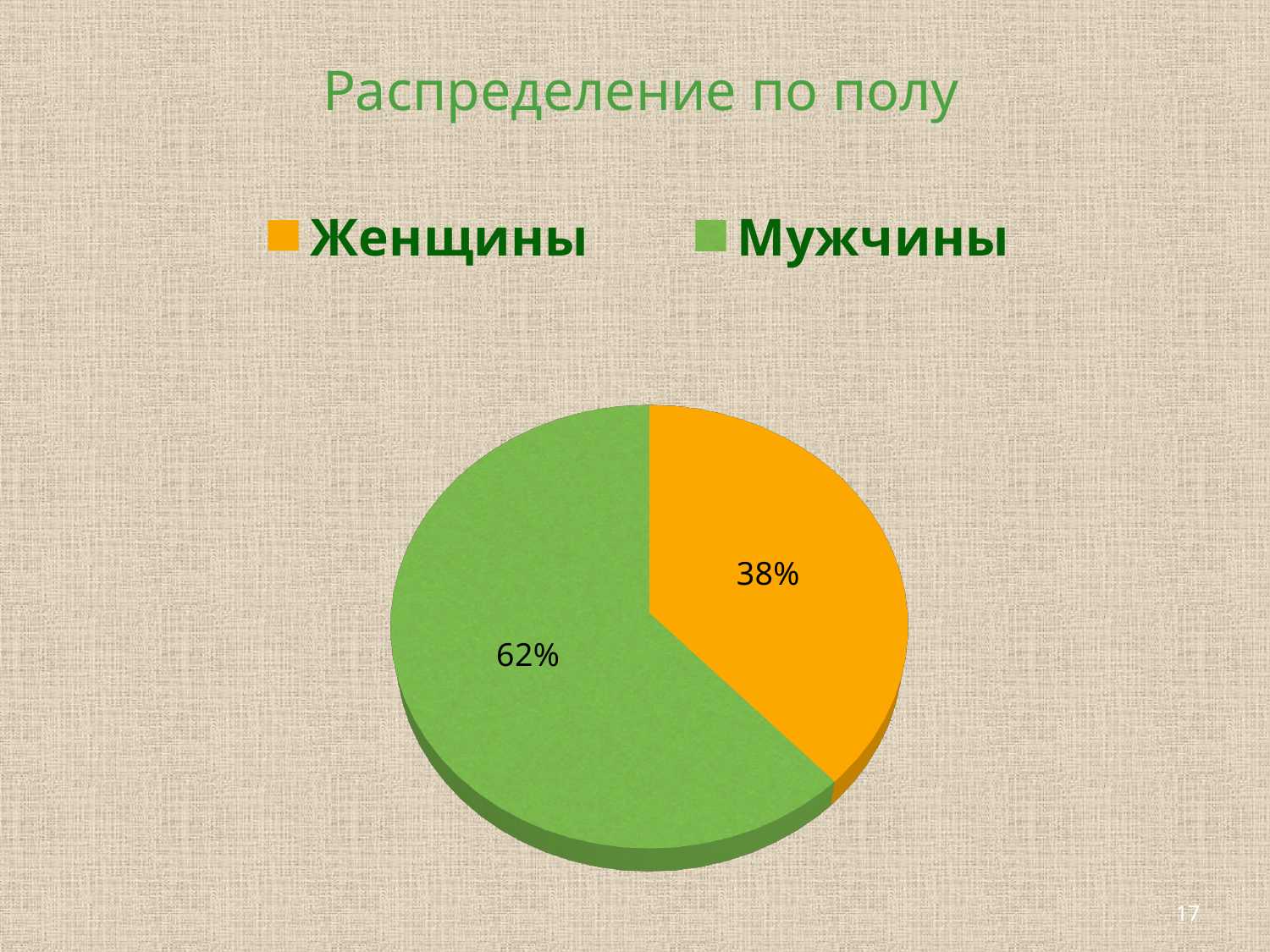
Which category has the largest slice of the pie? Мужчины What share of the pie does Мужчины represent? 62% How many entries does the legend list? 2 What kind of chart is shown on the slide? Pie chart How many slices does the pie chart have? 2 What is the title of the chart? Распределение по полу Which category has the smallest slice of the pie? Женщины What is the difference in percentage points between Мужчины and Женщины? 24 Which is larger, the share for Женщины or the share for Мужчины? Мужчины What colour is the slice for Женщины? Orange What share of the pie does Женщины represent? 38%